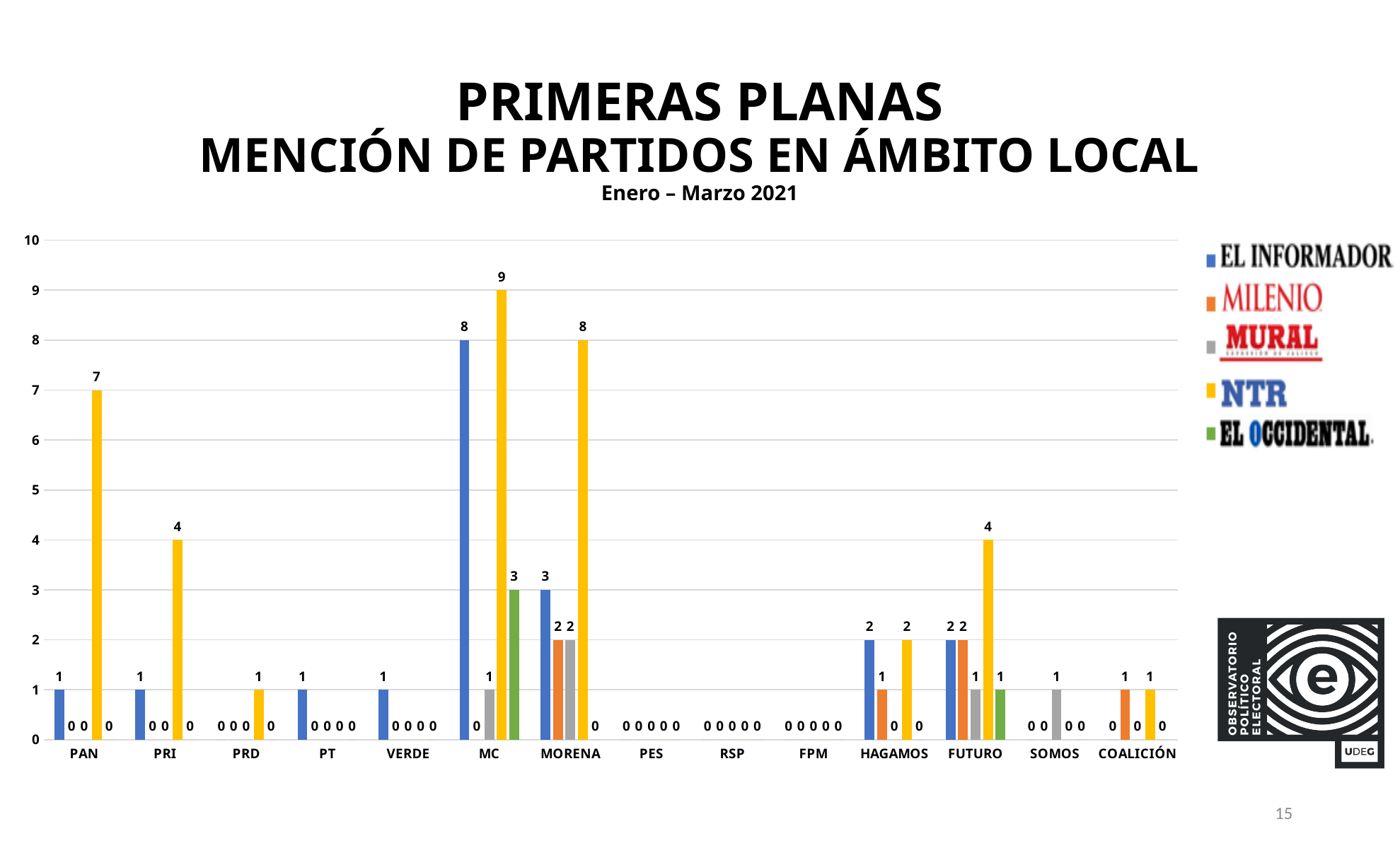
What kind of chart is shown on the slide? Bar chart Which is larger, the EL INFORMADOR value for MC or the EL INFORMADOR value for MORENA? MC How many series does the legend list? 5 What is the EL OCCIDENTAL value for MC? 3 Which party has the highest NTR value? MC What is the difference between the NTR values for MC and MORENA? 1 What is the NTR value for MC? 9 What is the NTR value for PAN? 7 What is the EL INFORMADOR value for MORENA? 3 Which party has the highest EL INFORMADOR value? MC How many parties are shown on the x axis? 14 Which is larger, the NTR value for PRI or the NTR value for FUTURO? They are equal (4)